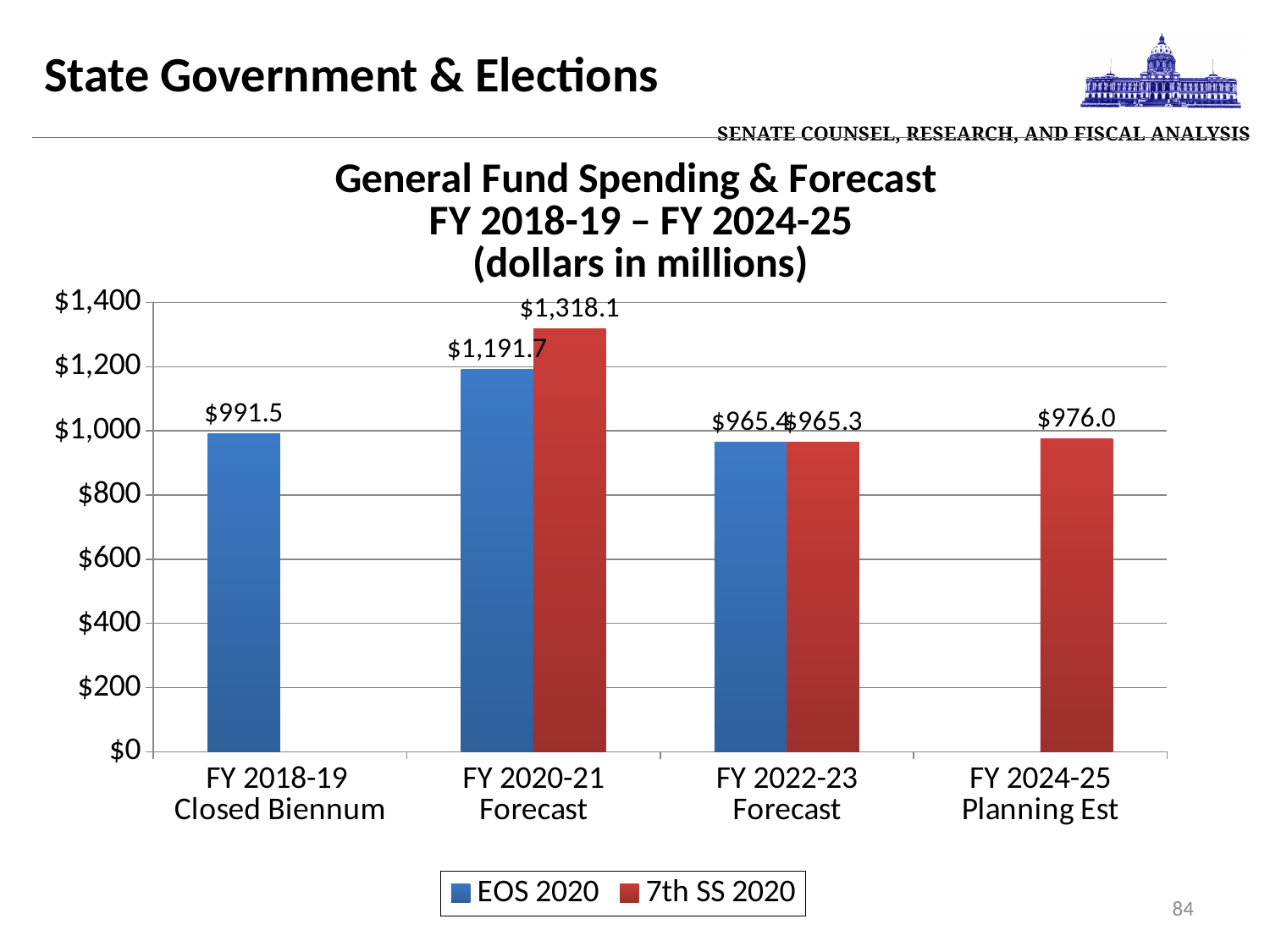
What kind of chart is shown on the slide? Bar chart What is the 7th SS 2020 value for FY 2020-21 Forecast? $1,318.1 How many series does the legend list? 2 Which category has the lowest EOS 2020 value? FY 2022-23 Forecast Is the EOS 2020 value for FY 2018-19 Closed Biennum greater or less than $1,000? less What is the difference between the 7th SS 2020 and EOS 2020 values for FY 2020-21 Forecast? $126.4 Which category has the highest 7th SS 2020 value? FY 2020-21 Forecast Which is larger for FY 2020-21 Forecast: the EOS 2020 value or the 7th SS 2020 value? 7th SS 2020 What is the EOS 2020 value for FY 2018-19 Closed Biennum? $991.5 How many categories are shown on the x axis? 4 What is the EOS 2020 value for FY 2020-21 Forecast? $1,191.7 What is the 7th SS 2020 value for FY 2024-25 Planning Est? $976.0